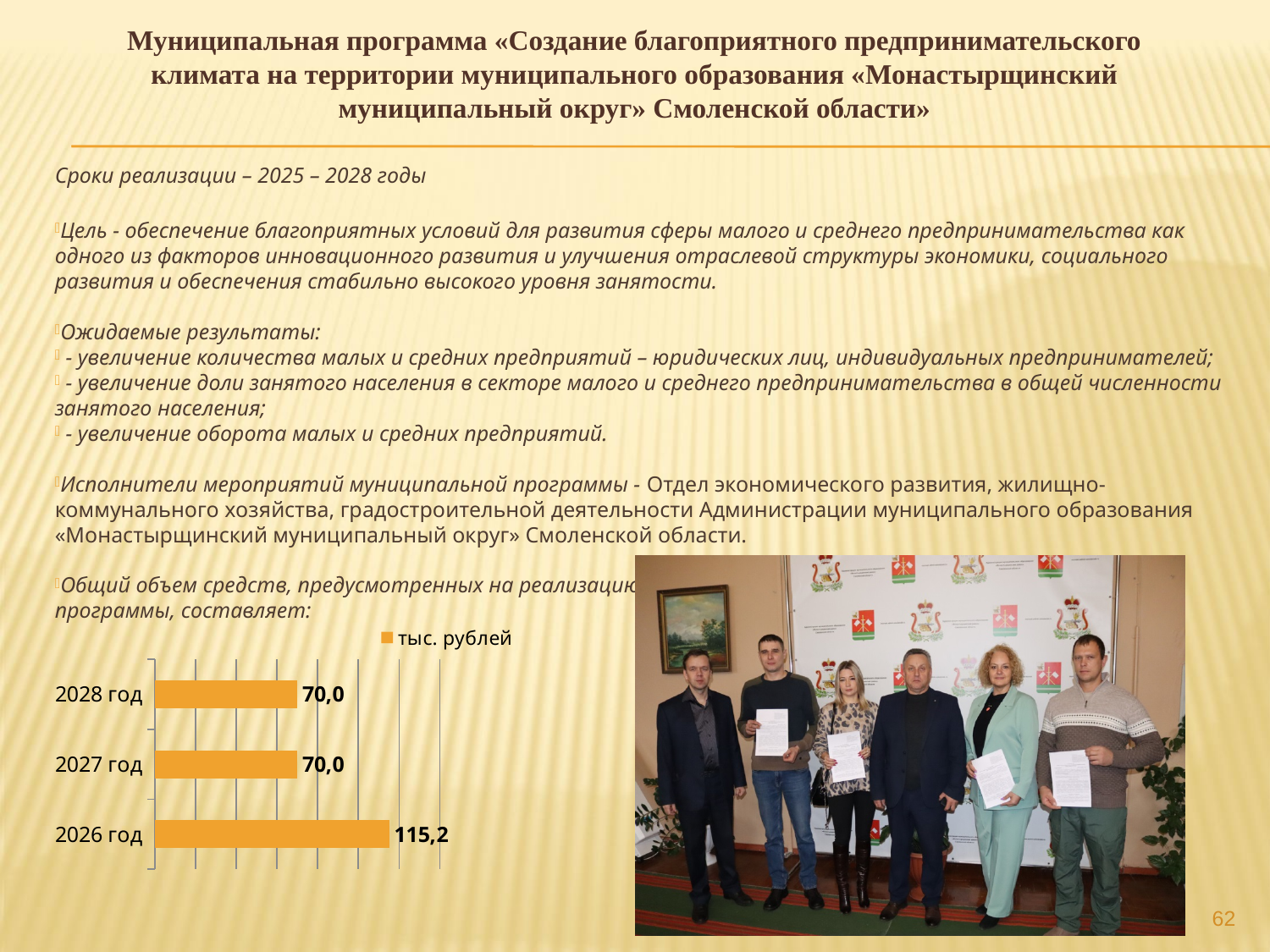
Are the values for 2027 год and 2028 год equal? Yes What is the difference between the values for 2026 год and 2027 год? 45,2 What is the value for 2028 год? 70,0 What is the value for 2027 год? 70,0 Which is larger, the value for 2026 год or the value for 2028 год? 2026 год Which year has the highest value? 2026 год What is the legend entry of the chart? тыс. рублей How many series does the legend list? 1 What is the value for 2026 год? 115,2 How many categories (years) are shown in the chart? 3 What is the total of the values for 2026 год, 2027 год and 2028 год? 255,2 What kind of chart is shown on the slide? bar chart